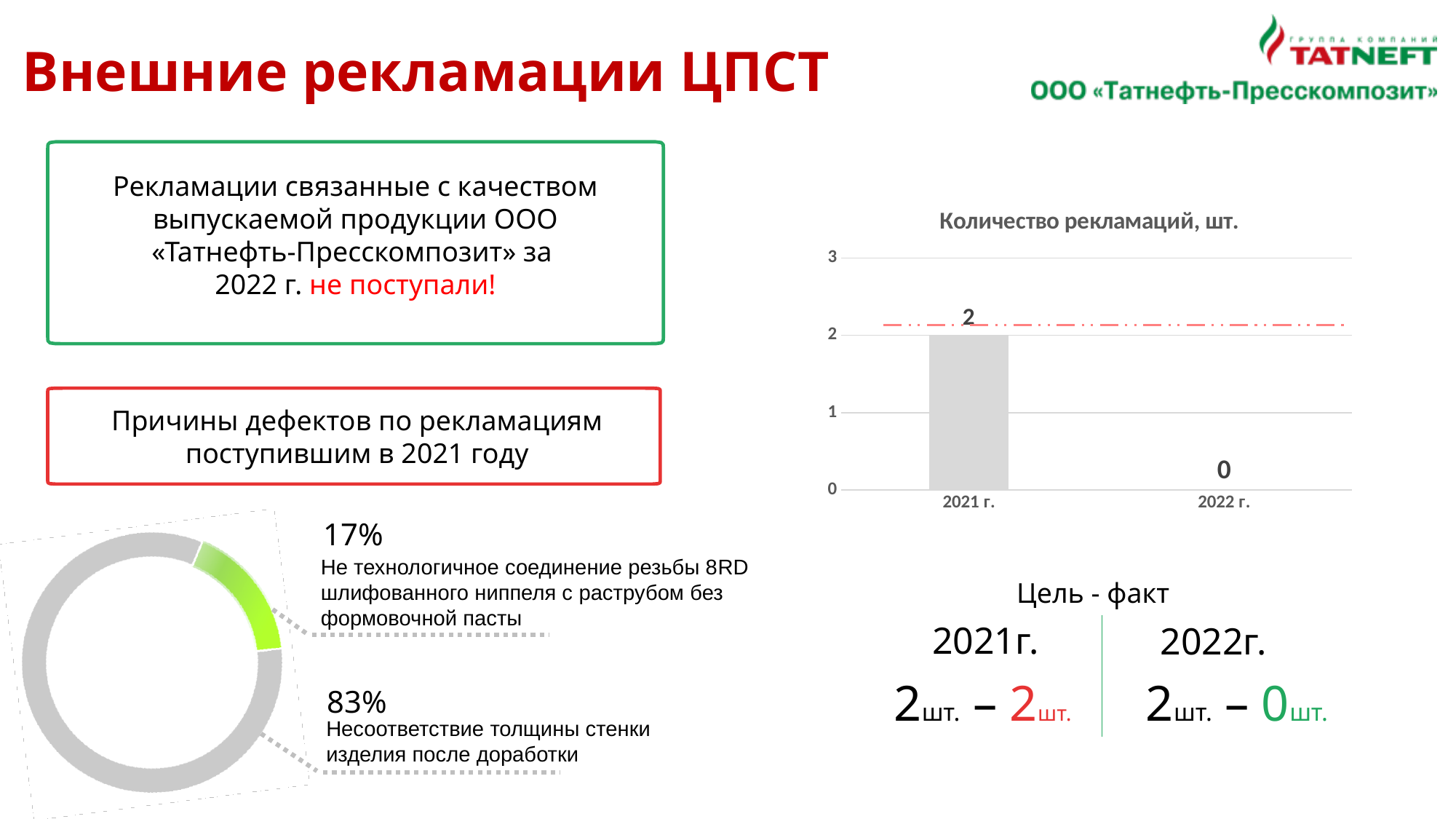
In the chart titled "Количество рекламаций, шт.", do the values rise or fall from 2021 г. to 2022 г.? fall In the chart titled "Количество рекламаций, шт.", how many categories are shown on the x axis? 2 What kind of chart is the one titled "Количество рекламаций, шт."? bar chart In the chart titled "Количество рекламаций, шт.", what is the value for 2022 г.? 0 In the donut chart at the bottom left of the slide, what share is labelled "Несоответствие толщины стенки изделия после доработки"? 83% In the chart titled "Количество рекламаций, шт.", what is the value for 2021 г.? 2 In the donut chart at the bottom left of the slide, what share is labelled "Не технологичное соединение резьбы 8RD шлифованного ниппеля с раструбом без формовочной пасты"? 17% In the chart titled "Количество рекламаций, шт.", which year has the lowest value? 2022 г. In the chart titled "Количество рекламаций, шт.", which year has the higher value? 2021 г. In the donut chart at the bottom left of the slide, how many slices are shown? 2 In the chart titled "Количество рекламаций, шт.", what is the difference between the values for 2021 г. and 2022 г.? 2 In the chart titled "Количество рекламаций, шт.", is the value for 2021 г. greater or less than 1? greater